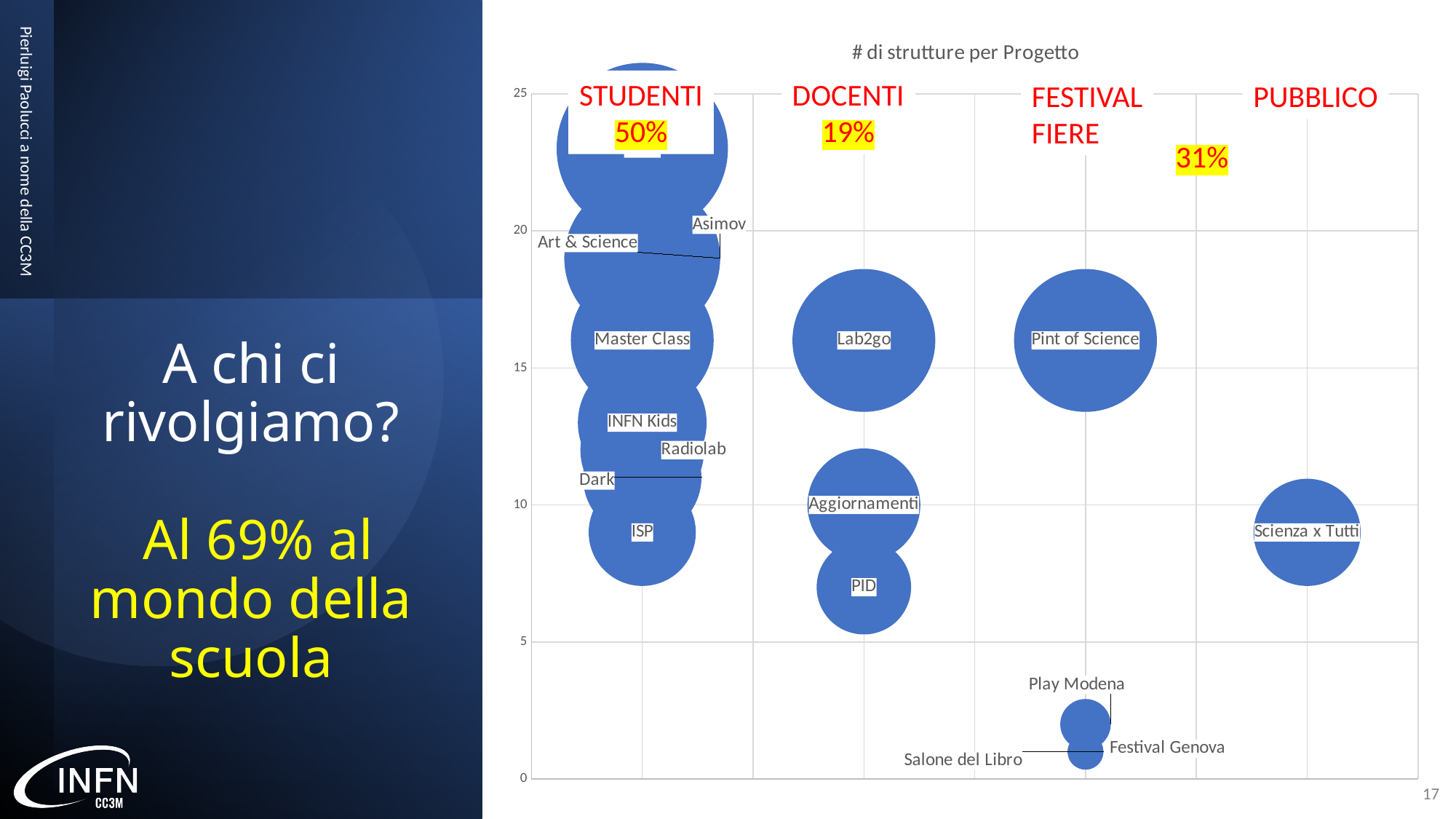
Is the value for Scienza x Tutti greater or less than 10? less What percentage is shown under the STUDENTI group? 50% Which has the higher value, Lab2go or PID? Lab2go Which has the higher value, Pint of Science or Play Modena? Pint of Science Is the value for Lab2go greater or less than 15? greater What is the title of the chart? # di strutture per Progetto Is the value for Play Modena greater or less than 5? less How many audience groups are labelled across the top of the chart? 4 What percentage is shown under the DOCENTI group? 19% What kind of chart is shown on the slide? bubble chart